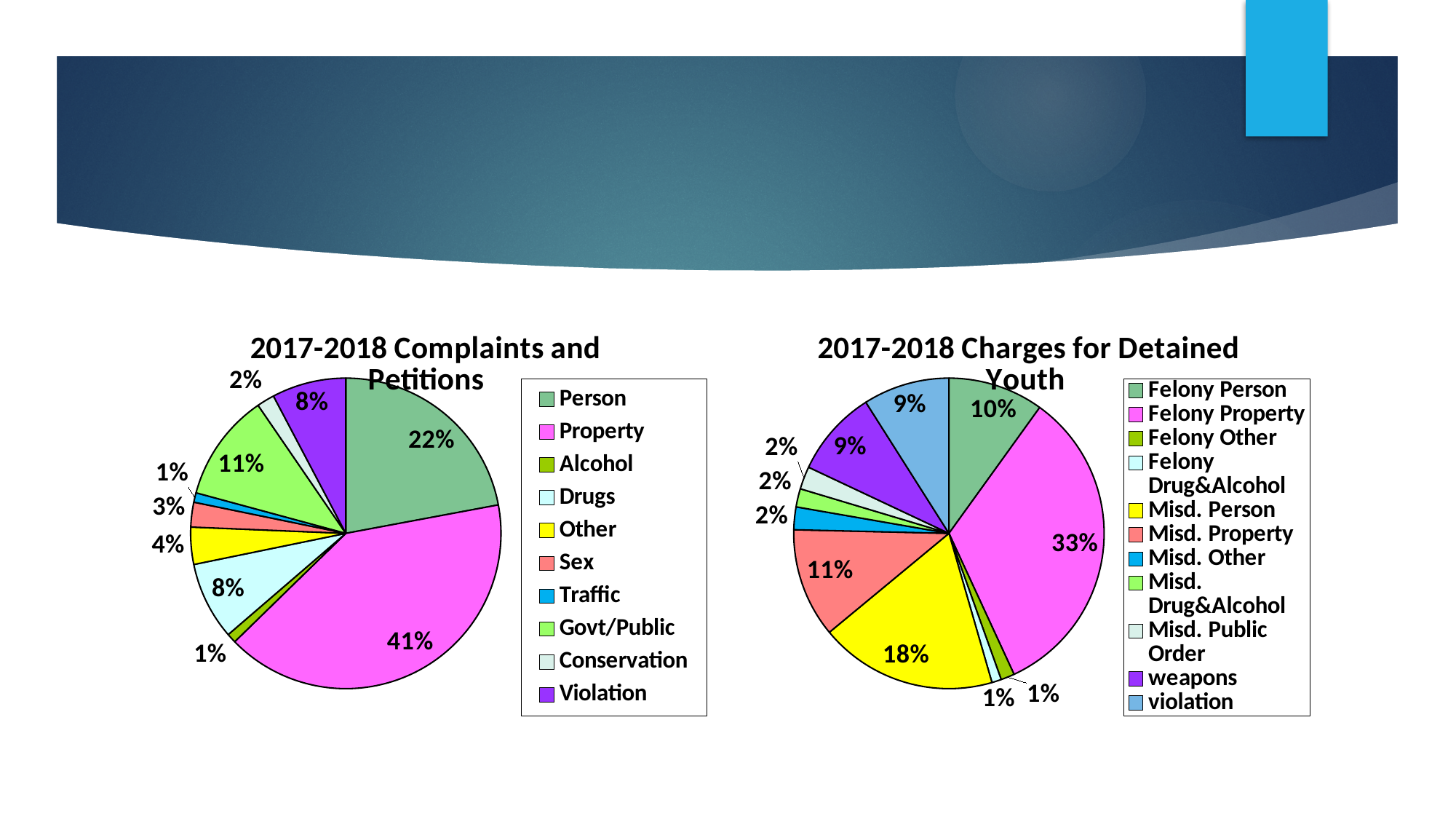
In the '2017-2018 Complaints and Petitions' chart, what is the difference between the Person and Drugs shares? 14% In the '2017-2018 Complaints and Petitions' chart, which category has the largest slice? Property How many categories does the legend of the '2017-2018 Charges for Detained Youth' chart list? 11 In the '2017-2018 Complaints and Petitions' chart, what share does Govt/Public have? 11% What type of chart is the '2017-2018 Charges for Detained Youth' chart? Pie chart In the '2017-2018 Complaints and Petitions' chart, what share does Property have? 41% In the '2017-2018 Charges for Detained Youth' chart, what share does Misd. Person have? 18% In the '2017-2018 Charges for Detained Youth' chart, what is the difference between the Misd. Person and Misd. Property shares? 7% How many categories does the legend of the '2017-2018 Complaints and Petitions' chart list? 10 In the '2017-2018 Charges for Detained Youth' chart, which category has the largest slice? Felony Property In the '2017-2018 Complaints and Petitions' chart, which is larger, Other or Sex? Other In the '2017-2018 Charges for Detained Youth' chart, what share does Felony Property have? 33%